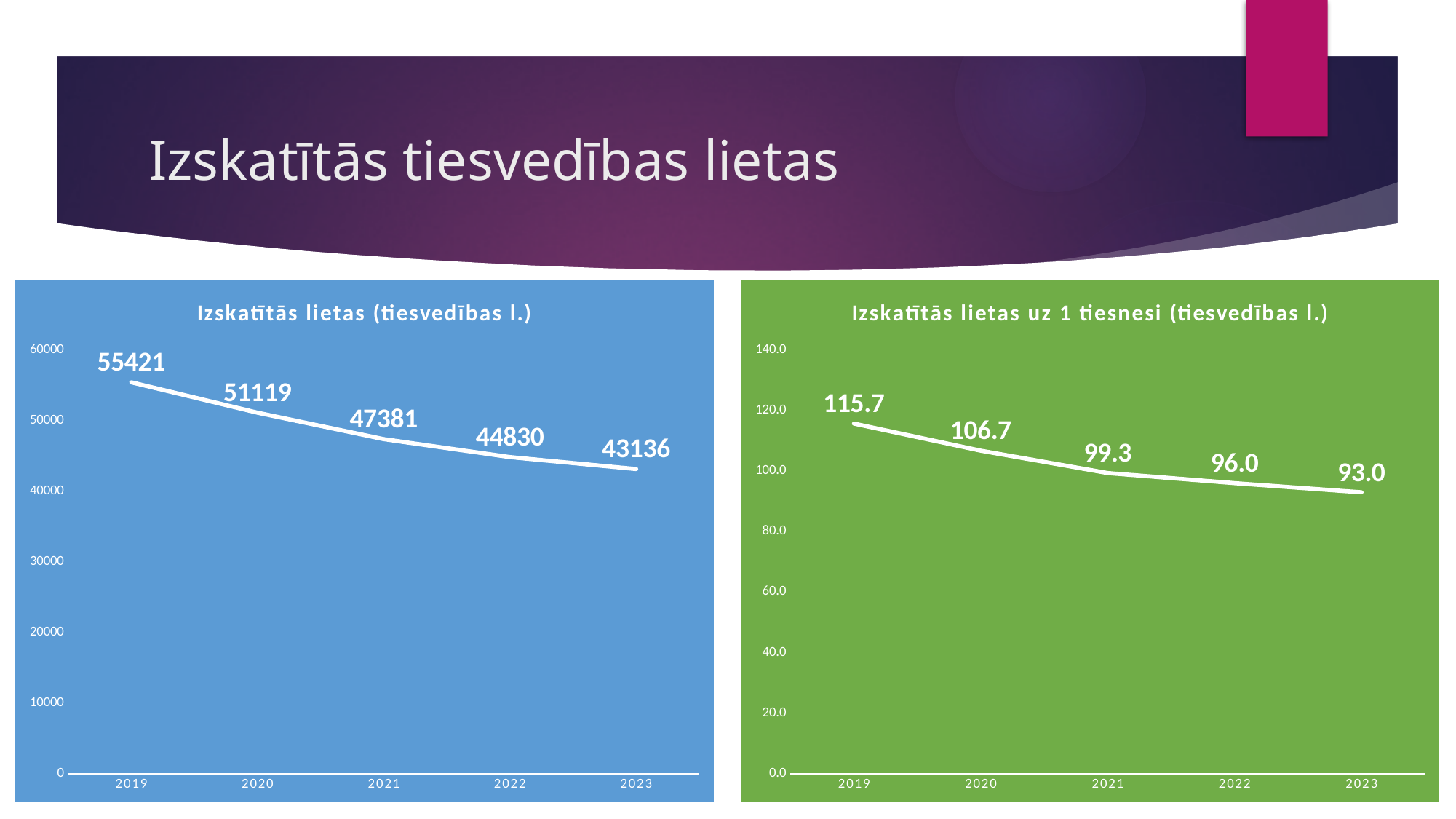
In the chart titled 'Izskatītās lietas uz 1 tiesnesi (tiesvedības l.)', which year has the highest value? 2019 In the chart titled 'Izskatītās lietas (tiesvedības l.)', do the values rise or fall from 2019 to 2023? fall In the chart titled 'Izskatītās lietas (tiesvedības l.)', what is the value for 2019? 55421 In the chart titled 'Izskatītās lietas (tiesvedības l.)', what is the value for 2023? 43136 In the chart titled 'Izskatītās lietas uz 1 tiesnesi (tiesvedības l.)', what is the value for 2020? 106.7 What kind of chart is the chart titled 'Izskatītās lietas (tiesvedības l.)'? line chart What is the title of the chart on the right side of the slide? Izskatītās lietas uz 1 tiesnesi (tiesvedības l.) In the chart titled 'Izskatītās lietas uz 1 tiesnesi (tiesvedības l.)', is the value for 2021 larger than the value for 2022? yes In the chart titled 'Izskatītās lietas (tiesvedības l.)', which year has the lowest value? 2023 In the chart titled 'Izskatītās lietas (tiesvedības l.)', what is the difference between the 2019 and 2020 values? 4302 In the chart titled 'Izskatītās lietas uz 1 tiesnesi (tiesvedības l.)', what is the difference between the 2022 and 2023 values? 3.0 In the chart titled 'Izskatītās lietas (tiesvedības l.)', how many years are plotted? 5